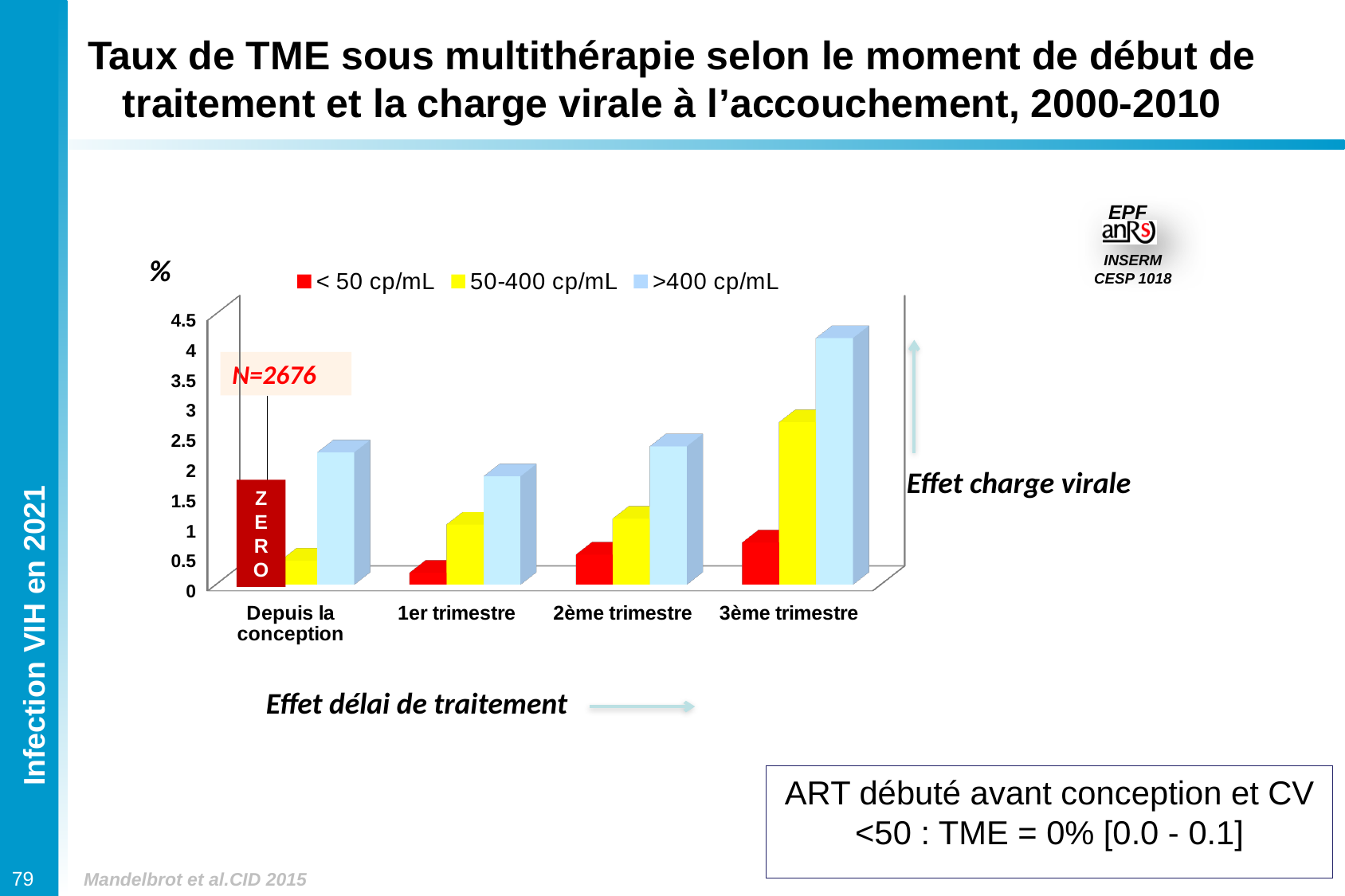
Is the value for >400 cp/mL at Depuis la conception greater or less than 1.5? greater What is the TME rate for < 50 cp/mL when ART was started before conception (Depuis la conception)? 0% Is the value for 50-400 cp/mL at 1er trimestre greater or less than 2? less Which category and series has the lowest bar in the chart? < 50 cp/mL at Depuis la conception How many series does the legend list? 3 How many treatment-start categories are shown on the x axis? 4 What sample size (N) is shown on the chart? N=2676 Do the values for the < 50 cp/mL series rise or fall from Depuis la conception to 3ème trimestre? rise Which category and series has the highest bar in the chart? >400 cp/mL at 3ème trimestre Is the value for >400 cp/mL at 3ème trimestre greater or less than 3.5? greater At 3ème trimestre, which is larger: the 50-400 cp/mL bar or the >400 cp/mL bar? >400 cp/mL What kind of chart is shown on the slide? bar chart